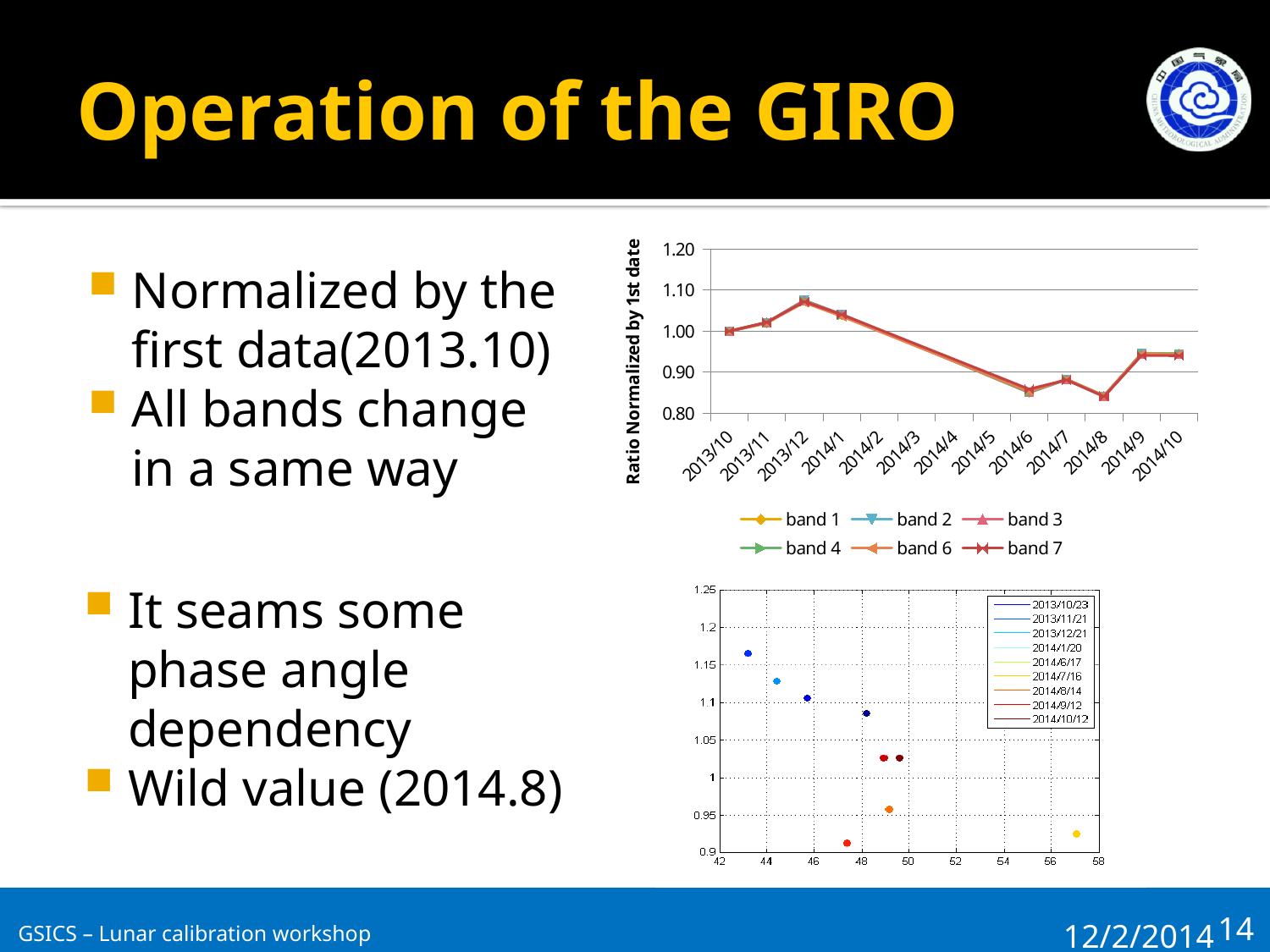
What is the y-axis title of the top chart? Ratio Normalized by 1st date In the top chart, do the values rise or fall between 2014/1 and 2014/6? fall How many series does the legend of the top chart list? 6 In the top chart, is the value at 2014/6 greater or less than 0.90? less How many entries does the legend of the bottom chart list? 9 In the top chart, what is the normalized ratio at 2013/10? 1.00 In the top chart, at which date is the normalized ratio highest? 2013/12 What kind of chart is the bottom chart on the slide? scatter chart How many dates are shown along the x axis of the top chart? 13 In the top chart, is the value at 2013/12 greater or less than 1.00? greater What kind of chart is the top chart on the slide? line chart In the top chart, at which date is the normalized ratio lowest? 2014/8